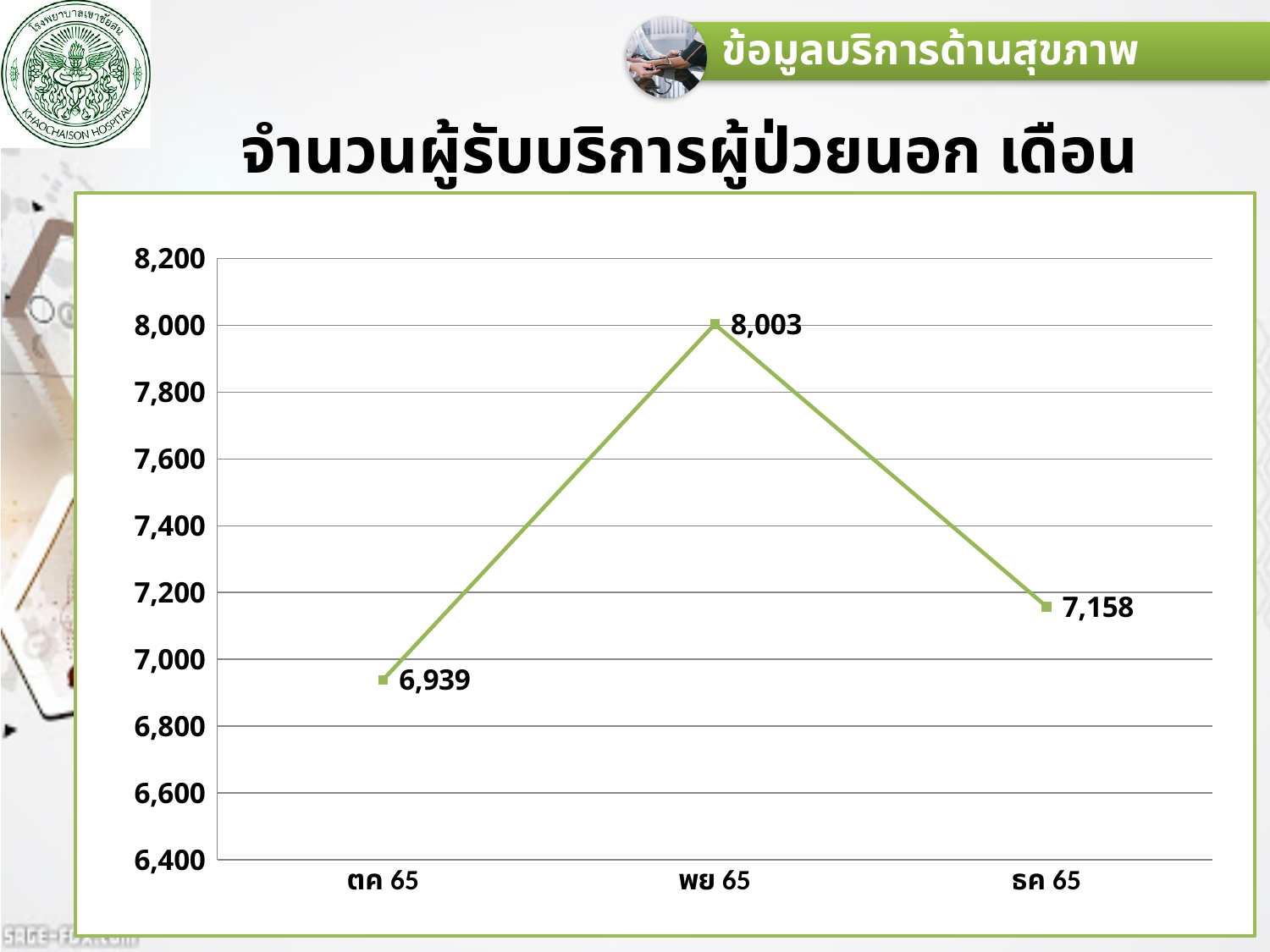
What is the value for ธค 65? 7,158 What kind of chart is shown on the slide? line chart What is the difference between the values for พย 65 and ธค 65? 845 How many months are plotted on the chart? 3 What is the value for พย 65? 8,003 Which is larger, the value for ธค 65 or the value for ตค 65? ธค 65 Does the value rise or fall from พย 65 to ธค 65? fall What is the difference between the values for พย 65 and ตค 65? 1,064 Which month has the highest value? พย 65 Is the value for ตค 65 greater or less than 7,000? less What is the value for ตค 65? 6,939 Which month has the lowest value? ตค 65